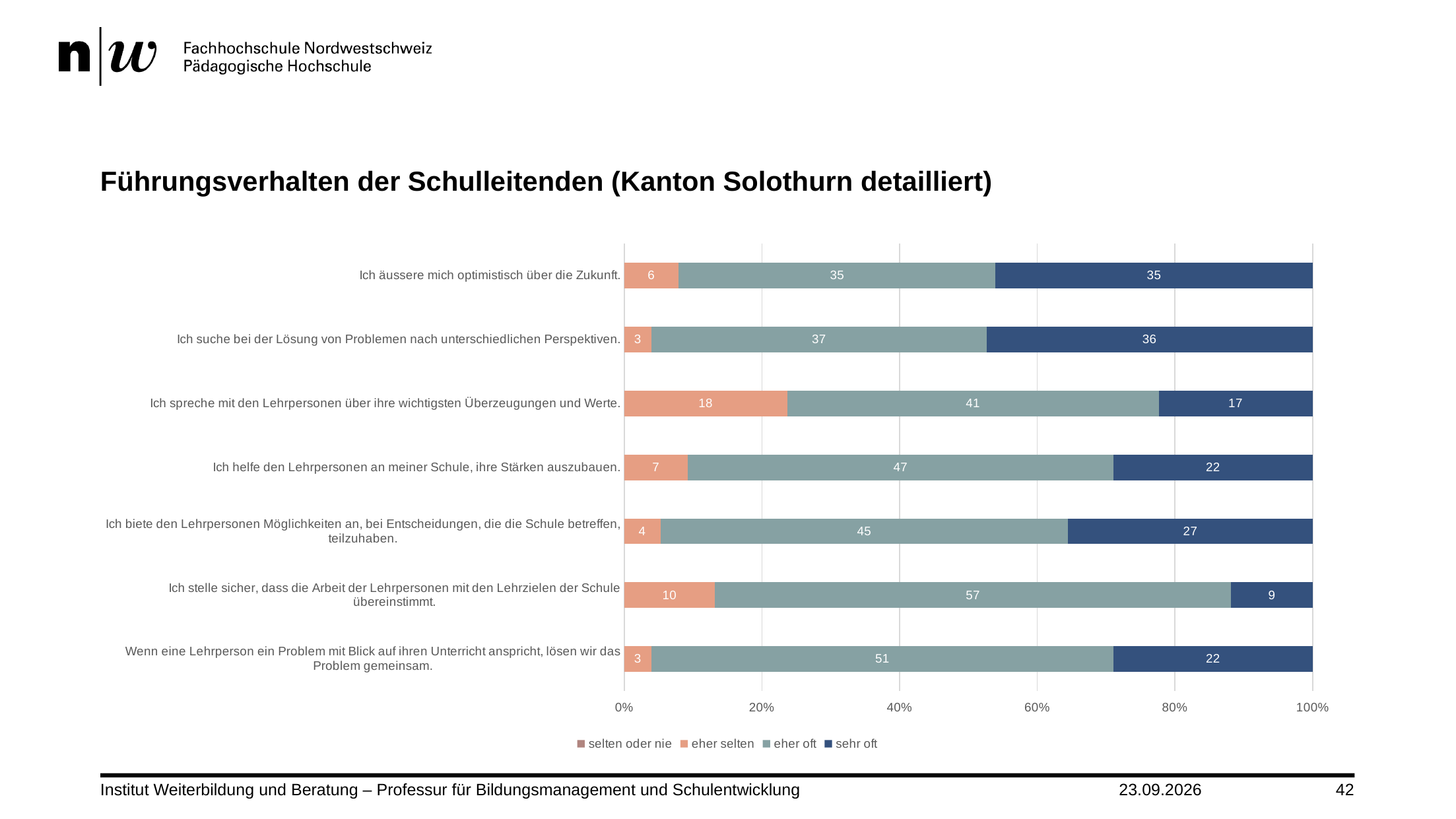
Which statement has the highest 'eher oft' value? Ich stelle sicher, dass die Arbeit der Lehrpersonen mit den Lehrzielen der Schule übereinstimmt. What kind of chart is shown on the slide? Stacked bar chart What is the difference between the 'sehr oft' values for 'Ich suche bei der Lösung von Problemen nach unterschiedlichen Perspektiven.' and 'Ich helfe den Lehrpersonen an meiner Schule, ihre Stärken auszubauen.'? 14 Which legend entry is shown in dark blue? sehr oft Which statement has the highest 'eher selten' value? Ich spreche mit den Lehrpersonen über ihre wichtigsten Überzeugungen und Werte. What is the value of the 'eher oft' segment for 'Ich stelle sicher, dass die Arbeit der Lehrpersonen mit den Lehrzielen der Schule übereinstimmt.'? 57 How many series does the legend list? 4 What is the value of the 'eher selten' segment for 'Ich spreche mit den Lehrpersonen über ihre wichtigsten Überzeugungen und Werte.'? 18 Which has the larger 'eher oft' value: 'Wenn eine Lehrperson ein Problem mit Blick auf ihren Unterricht anspricht, lösen wir das Problem gemeinsam.' or 'Ich helfe den Lehrpersonen an meiner Schule, ihre Stärken auszubauen.'? Wenn eine Lehrperson ein Problem mit Blick auf ihren Unterricht anspricht, lösen wir das Problem gemeinsam. How many statements (categories) are shown in the chart? 7 Which statement has the lowest 'sehr oft' value? Ich stelle sicher, dass die Arbeit der Lehrpersonen mit den Lehrzielen der Schule übereinstimmt. What is the value of the 'sehr oft' segment for 'Ich äussere mich optimistisch über die Zukunft.'? 35